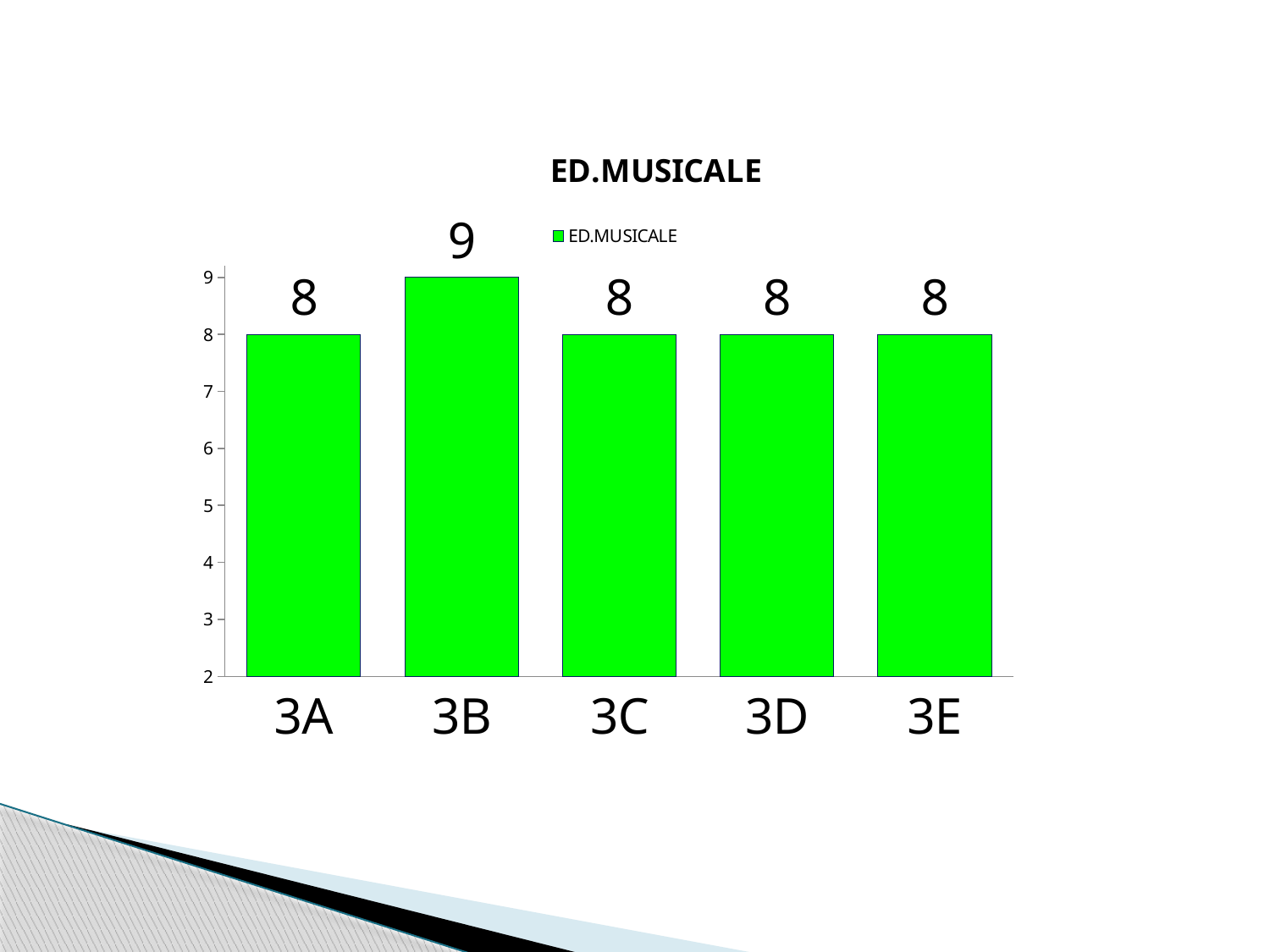
What kind of chart is shown? bar chart What is the difference between the values for 3B and 3C? 1 Is the value for 3C greater or less than 5? greater Which is larger, the value for 3B or the value for 3E? 3B What colour are the bars? green What is the value for 3D? 8 What is the value for 3B? 9 How many categories are shown on the x axis? 5 What is the value for 3A? 8 What is the title of the chart? ED.MUSICALE How many series does the legend list? 1 Which category has the highest value? 3B